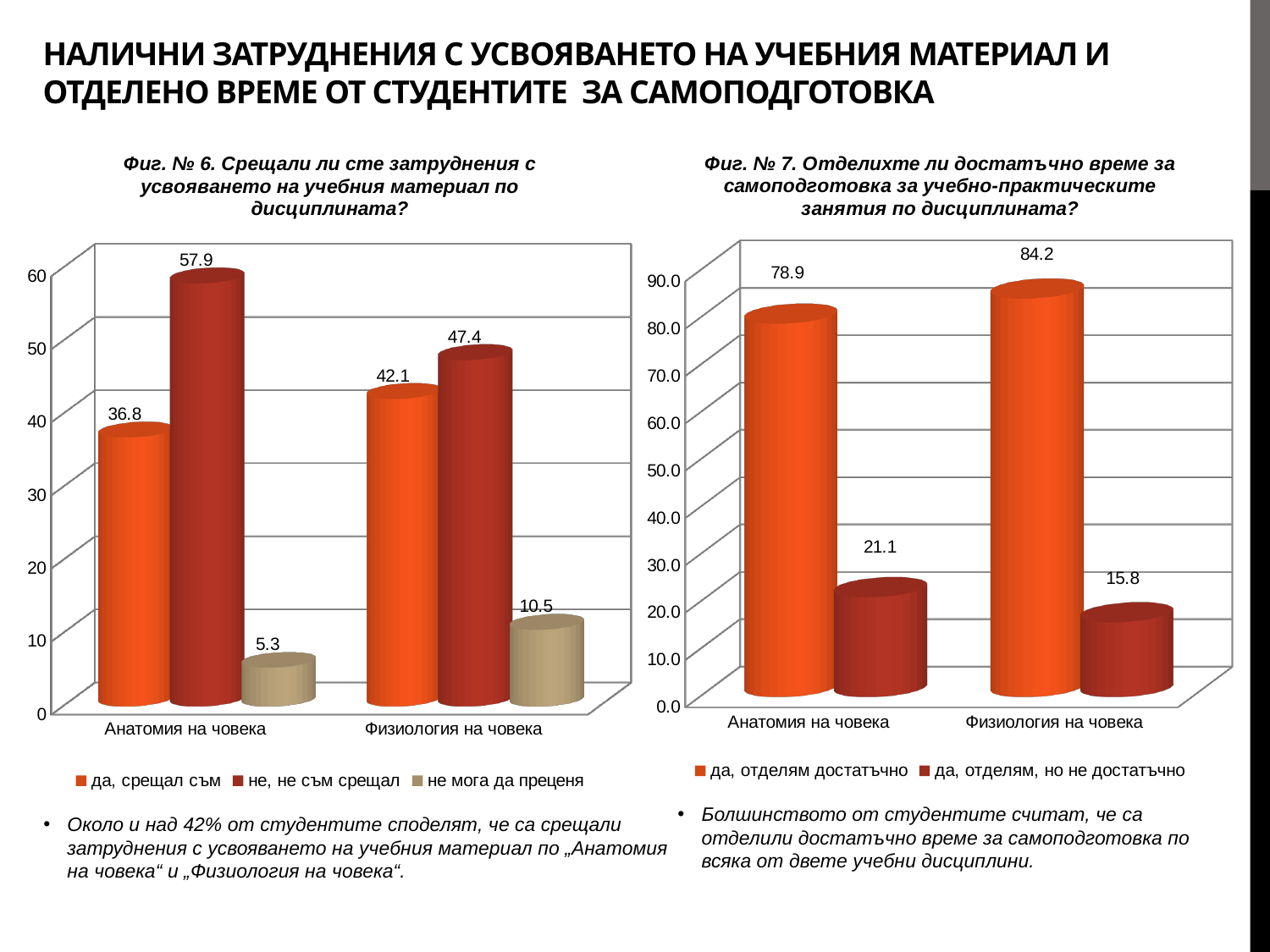
In the chart titled "Фиг. № 6" (left), which series has the lowest value for "Анатомия на човека"? не мога да преценя In the chart titled "Фиг. № 7" (right), what is the value for "да, отделям, но не достатъчно" for "Анатомия на човека"? 21.1 In the chart titled "Фиг. № 6" (left), how many series does the legend list? 3 In the chart titled "Фиг. № 6" (left), is the value for "да, срещал съм" for "Анатомия на човека" greater or less than 40? less What kind of chart is the chart titled "Фиг. № 7" (right)? bar chart In the chart titled "Фиг. № 7" (right), which category has the higher value for "да, отделям достатъчно"? Физиология на човека In the chart titled "Фиг. № 7" (right), what is the difference between "да, отделям достатъчно" and "да, отделям, но не достатъчно" for "Анатомия на човека"? 57.8 In the chart titled "Фиг. № 6" (left), what is the value for "не, не съм срещал" for "Анатомия на човека"? 57.9 In the chart titled "Фиг. № 6" (left), what is the difference between "не, не съм срещал" and "да, срещал съм" for "Физиология на човека"? 5.3 In the chart titled "Фиг. № 7" (right), what is the value for "да, отделям достатъчно" for "Физиология на човека"? 84.2 In the chart titled "Фиг. № 6" (left), what is the value for "не мога да преценя" for "Физиология на човека"? 10.5 In the chart titled "Фиг. № 7" (right), how many categories are shown on the x axis? 2